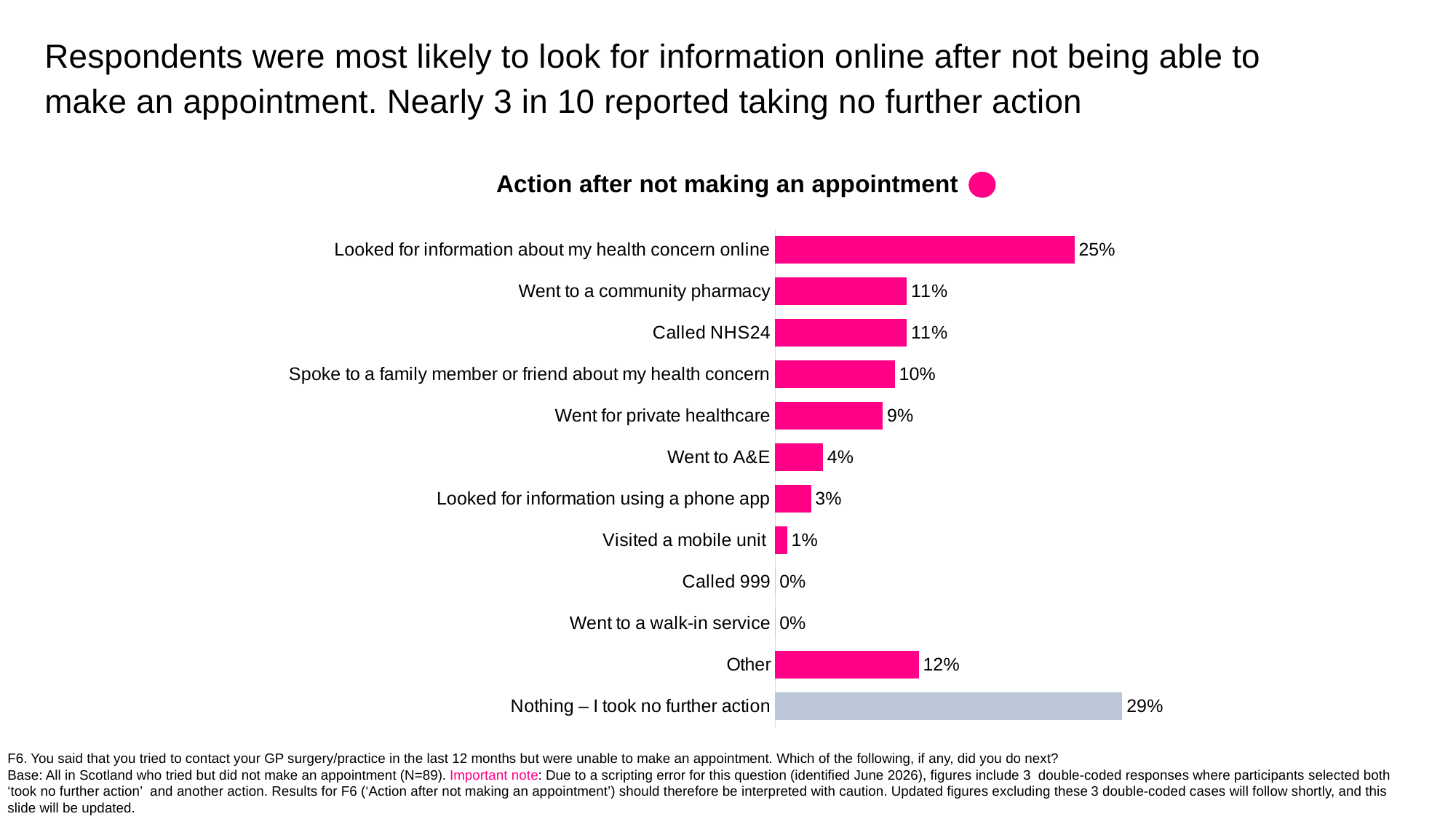
What is the value for 'Called 999'? 0% What is the title of the chart? Action after not making an appointment What kind of chart is shown on the slide? Bar chart Which bar is shown in a different colour (grey) from the rest? Nothing – I took no further action How many categories are shown in the chart? 12 What percentage of respondents went to a community pharmacy? 11% What percentage of respondents went for private healthcare? 9% Which category has the highest value in the chart? Nothing – I took no further action Which is larger: the value for 'Other' or the value for 'Called NHS24'? Other What is the difference between the percentage who looked for information online and the percentage who went to A&E? 21% What percentage of respondents looked for information about their health concern online? 25% What percentage of respondents said 'Nothing – I took no further action'? 29%